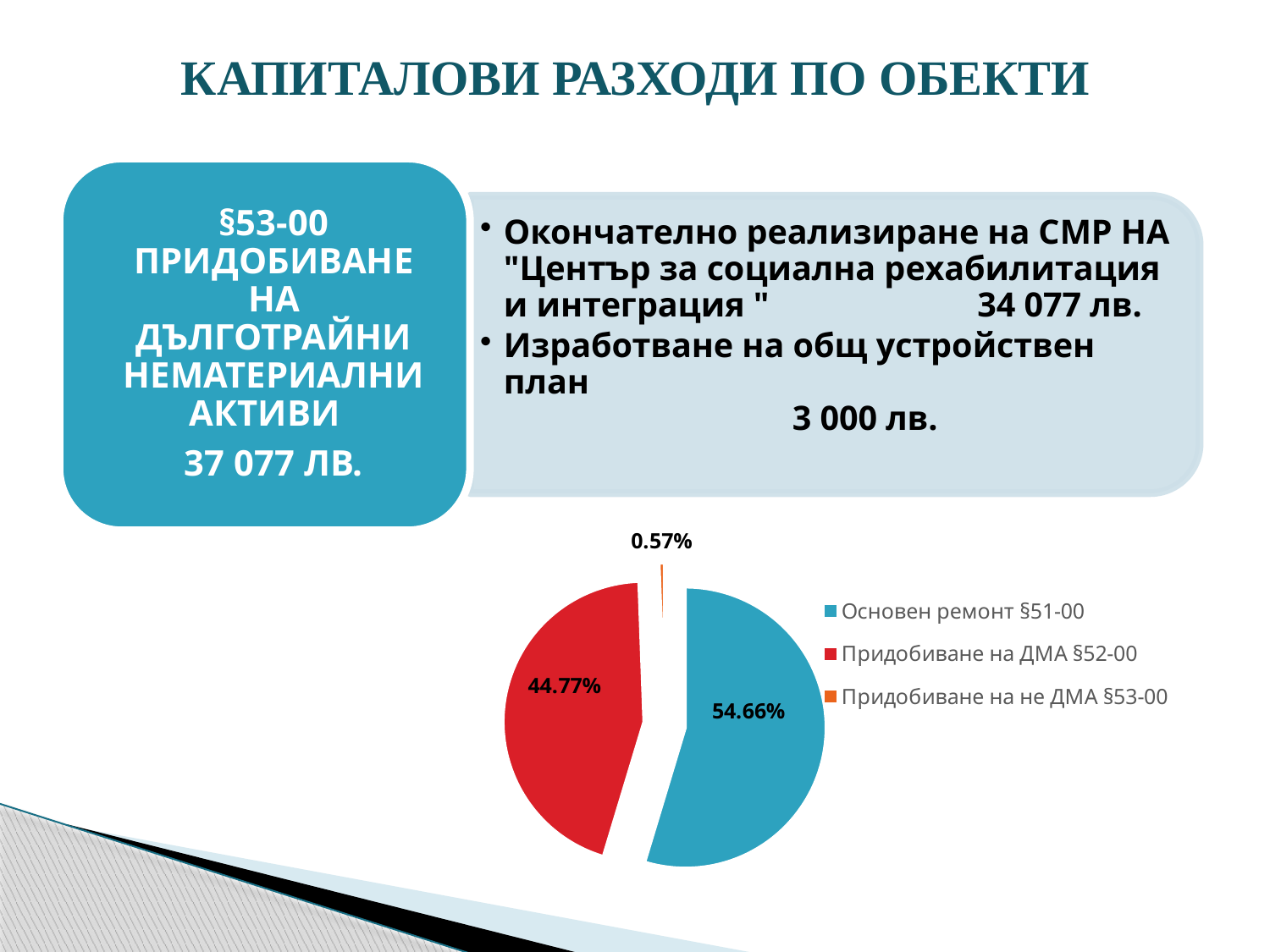
What is the difference in percentage points between "Основен ремонт §51-00" and "Придобиване на ДМА §52-00"? 9.89 How many slices does the pie chart have? 3 Which category has the largest slice of the pie? Основен ремонт §51-00 What share of the pie does "Придобиване на не ДМА §53-00" have? 0.57% What share of the pie does "Придобиване на ДМА §52-00" have? 44.77% What colour is the slice for "Основен ремонт §51-00" in the pie chart? blue What kind of chart is shown on the slide? pie chart How many entries does the legend of the pie chart list? 3 Which is larger: the slice for "Придобиване на ДМА §52-00" or the slice for "Придобиване на не ДМА §53-00"? Придобиване на ДМА §52-00 Which category has the smallest slice of the pie? Придобиване на не ДМА §53-00 What colour is the slice for "Придобиване на ДМА §52-00" in the pie chart? red What share of the pie does "Основен ремонт §51-00" have? 54.66%